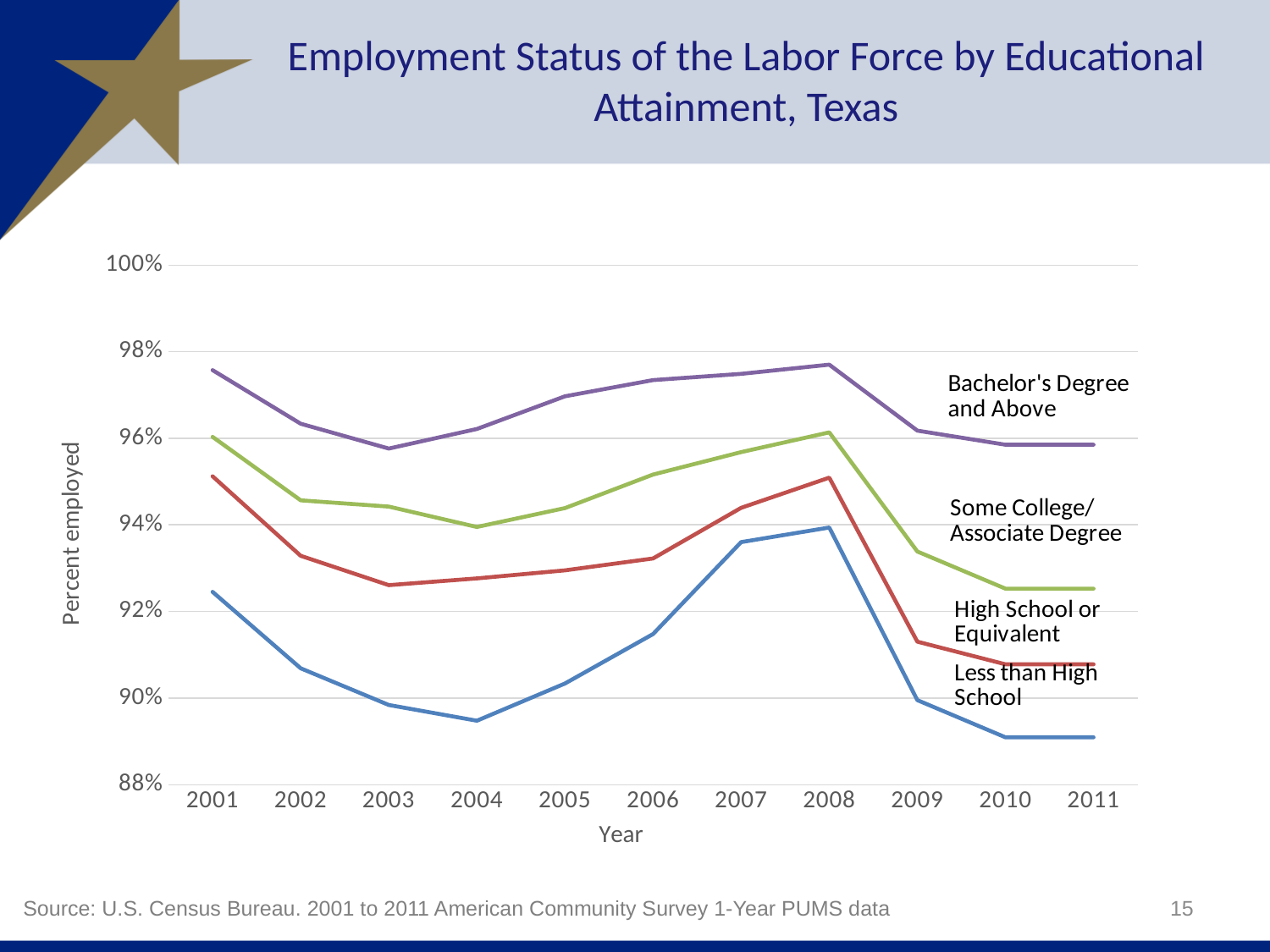
Is the value for High School or Equivalent in 2009 greater or less than 92%? less In which year does the Bachelor's Degree and Above line reach its highest value? 2008 What kind of chart is shown on the slide? Line chart What is the label on the vertical axis of the chart? Percent employed Is the value for High School or Equivalent in 2008 greater or less than 94%? greater Is the value for Less than High School in 2004 greater or less than 90%? less In which year does the Less than High School line reach its highest value? 2008 Does the Less than High School line rise or fall from 2008 to 2010? Fall How many educational attainment series are plotted on the chart? 4 In 2008, which is higher: Bachelor's Degree and Above or Less than High School? Bachelor's Degree and Above How many years are plotted along the x axis? 11